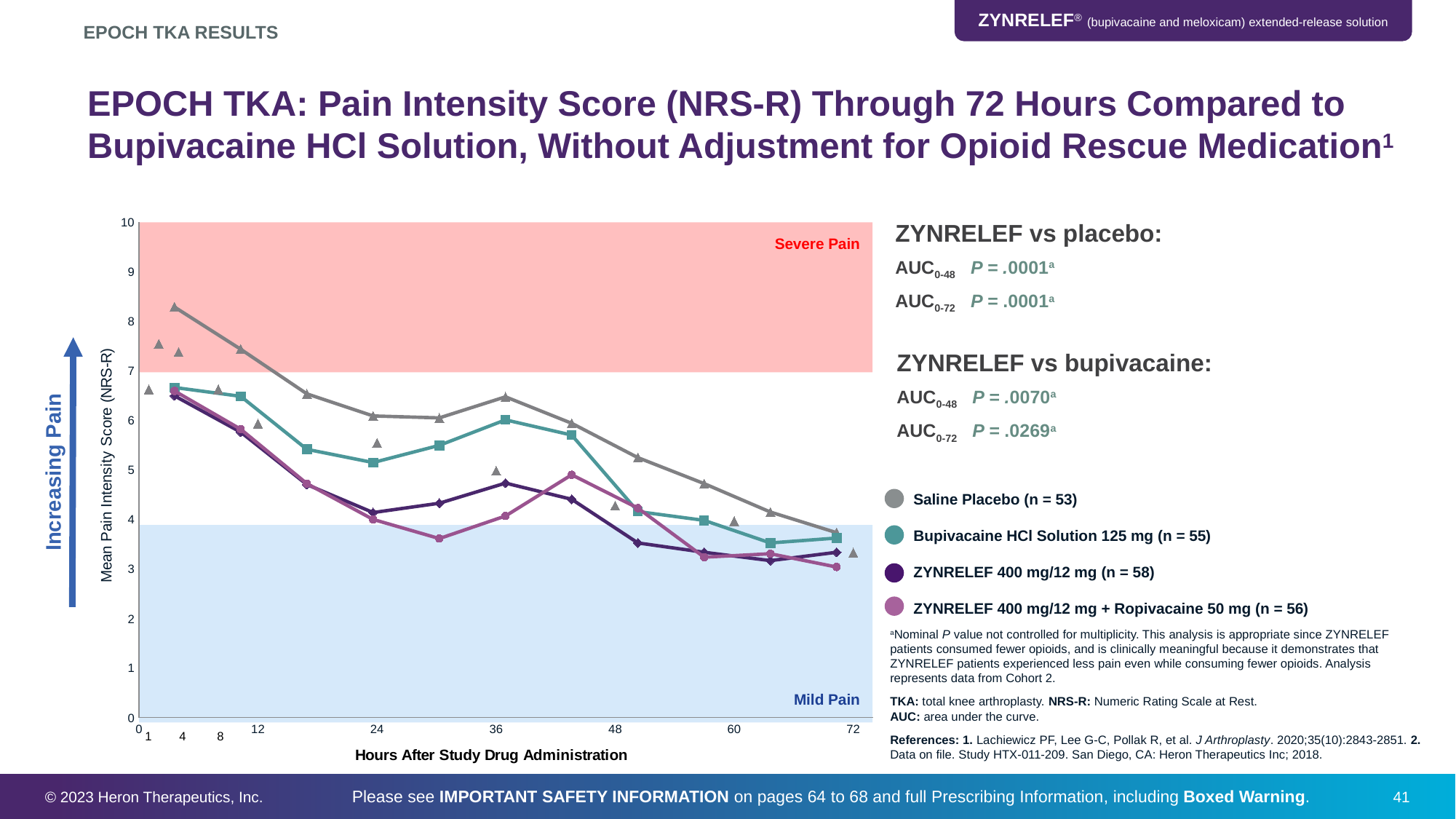
At 36 hours, which is larger: the Bupivacaine HCl Solution 125 mg value or the ZYNRELEF 400 mg/12 mg value? Bupivacaine HCl Solution 125 mg Is the Saline Placebo value at 72 hours greater or less than 4? less How many series does the chart legend list? 4 Does the Saline Placebo line rise or fall from 4 hours to 72 hours? fall Is the ZYNRELEF 400 mg/12 mg value at 72 hours greater or less than 4? less What is the title of the x axis of the chart? Hours After Study Drug Administration Which series has the highest value at 4 hours? Saline Placebo What kind of chart is shown on the slide? line chart What is the title of the y axis of the chart? Mean Pain Intensity Score (NRS-R)